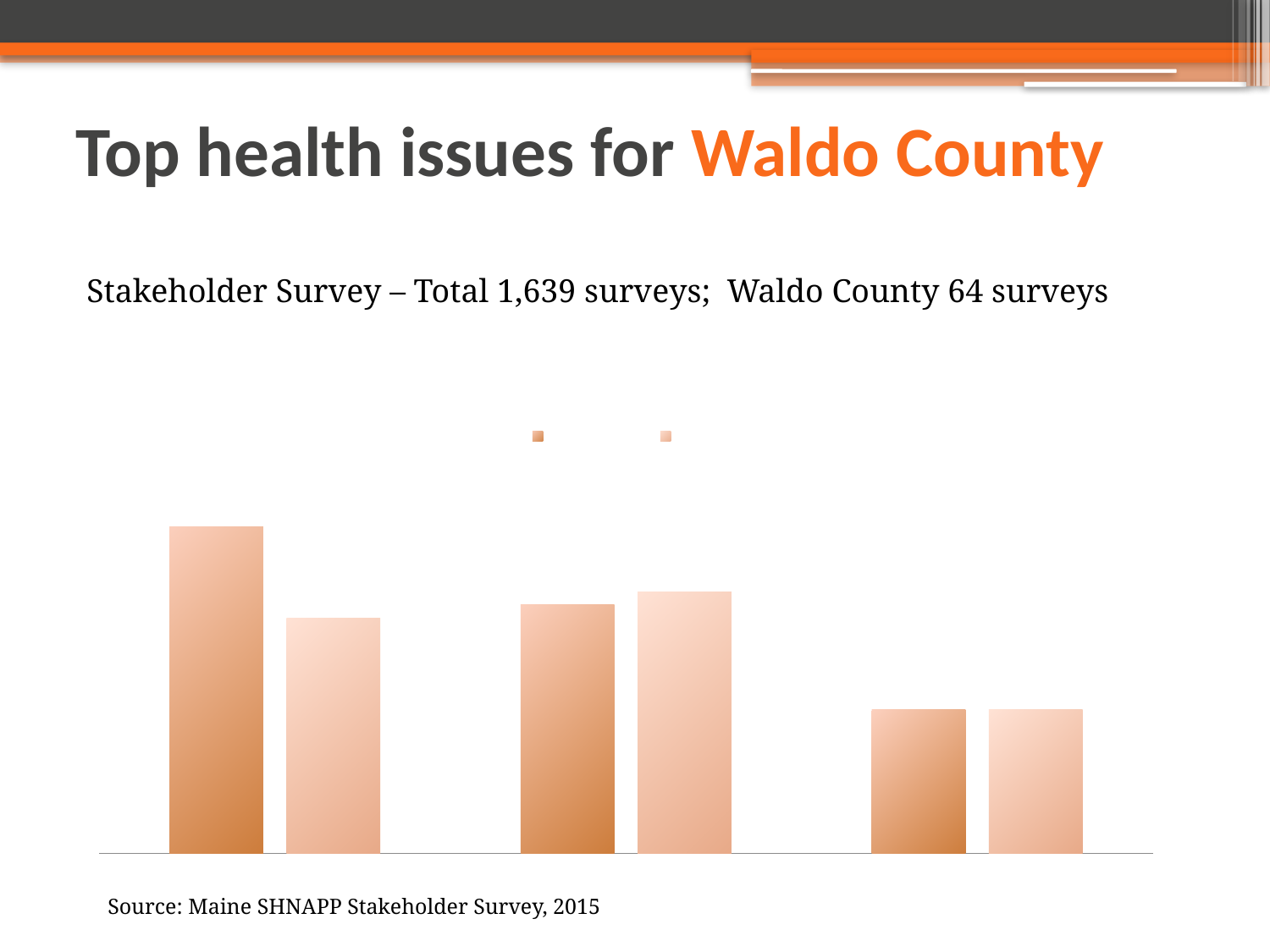
In the leftmost group of bars, is the darker orange bar or the lighter orange bar taller? the darker orange bar Do the heights of the darker orange bars rise or fall from left to right across the groups? fall Which group of bars has the shortest bars on the chart? the rightmost group Is the darker orange bar in the leftmost group taller or shorter than the darker orange bar in the middle group? taller How many series does the chart's legend list? 2 What two colours are used for the bars in the chart? darker orange and lighter orange What is the source cited below the chart? Maine SHNAPP Stakeholder Survey, 2015 What kind of chart is shown on the slide? bar chart Which group of bars contains the tallest bar on the chart? the leftmost group How many groups of bars does the chart show? 3 How many bars are plotted in total on the chart? 6